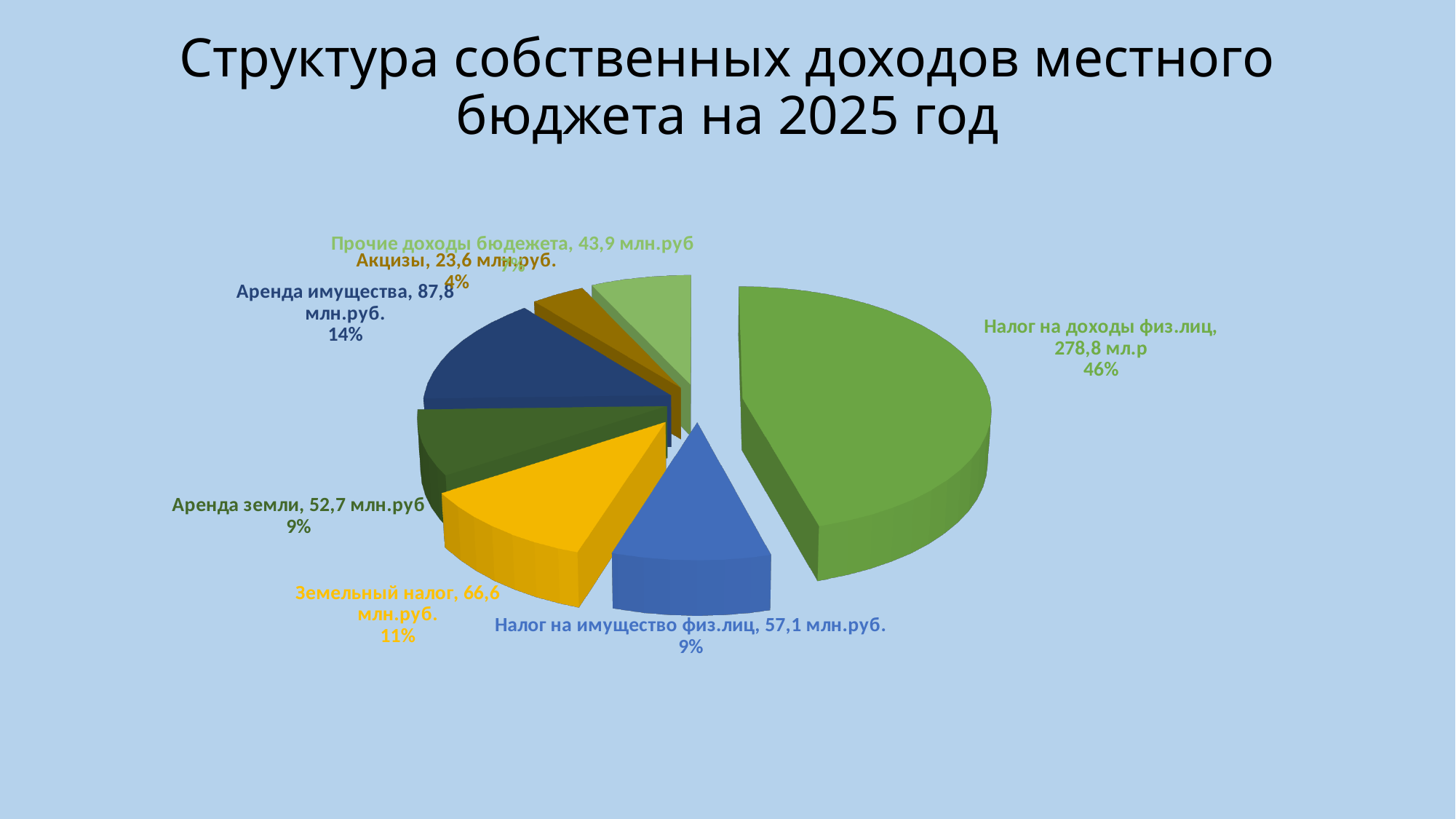
How many slices does the pie chart have? 7 What is the value shown for Прочие доходы бюджета? 43,9 млн.руб What is the title of the chart on the slide? Структура собственных доходов местного бюджета на 2025 год Which category has the largest share of the pie? Налог на доходы физ.лиц What is the value shown for Налог на доходы физ.лиц? 278,8 мл.р What kind of chart is shown on the slide? Pie chart What is the difference between the values for Налог на доходы физ.лиц and Налог на имущество физ.лиц? 221,7 What is the value shown for Акцизы? 23,6 млн.руб. Which category has the smallest share of the pie? Акцизы Which is larger, Земельный налог or Аренда земли? Земельный налог What is the value shown for Аренда имущества? 87,8 млн.руб. What share of the pie does Аренда имущества represent? 14%